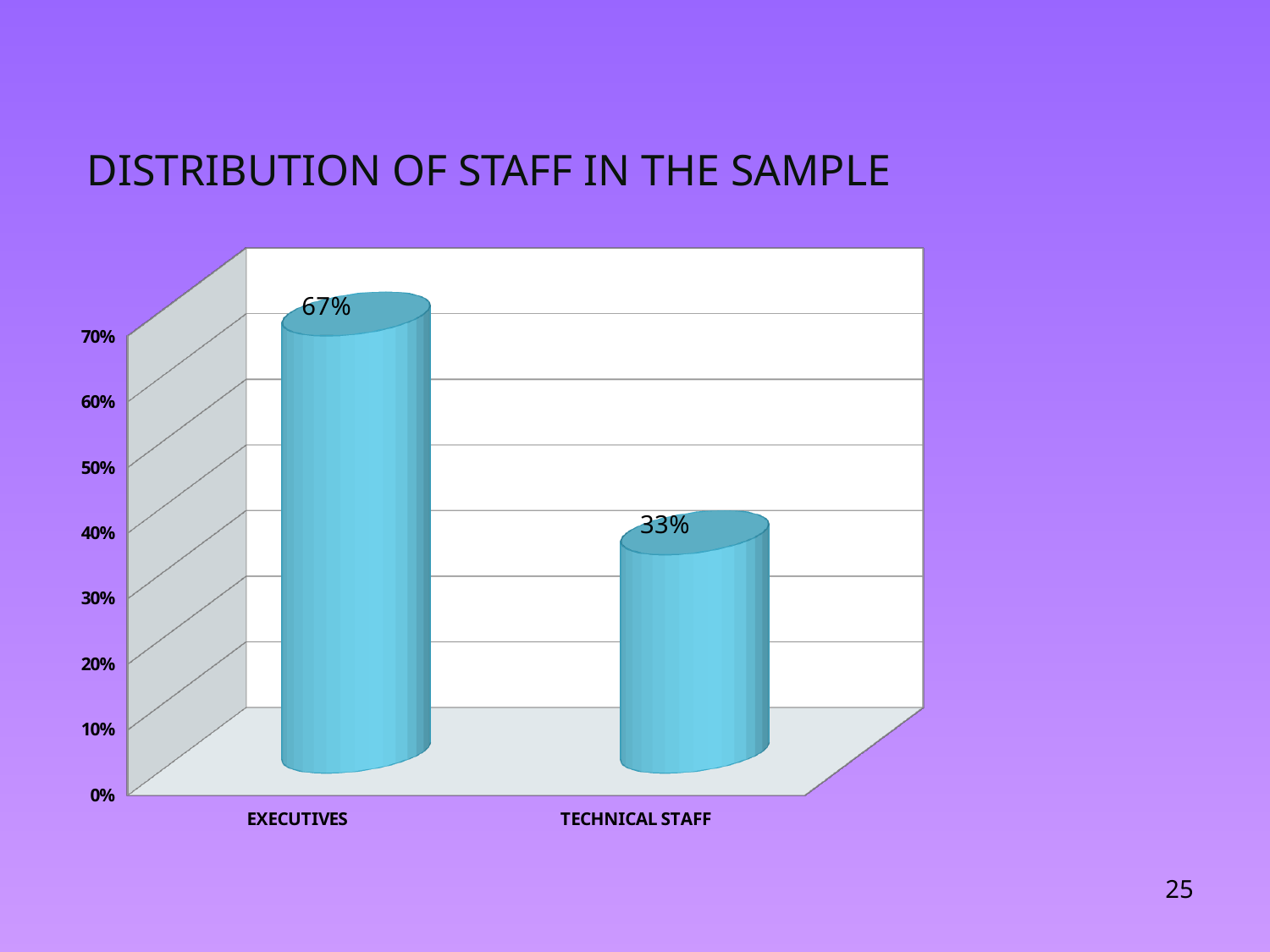
Is the value for EXECUTIVES greater or less than 60%? greater How many categories are shown on the x axis? 2 Which category has the highest value? EXECUTIVES Which category has the lowest value? TECHNICAL STAFF What is the value for EXECUTIVES? 67% What kind of chart is shown on the slide? bar chart Is the value for TECHNICAL STAFF greater or less than 50%? less Which is larger, the value for EXECUTIVES or the value for TECHNICAL STAFF? EXECUTIVES What is the title of the slide? DISTRIBUTION OF STAFF IN THE SAMPLE What is the difference between the values for EXECUTIVES and TECHNICAL STAFF? 34% What is the highest value shown on the y axis? 70% What is the value for TECHNICAL STAFF? 33%